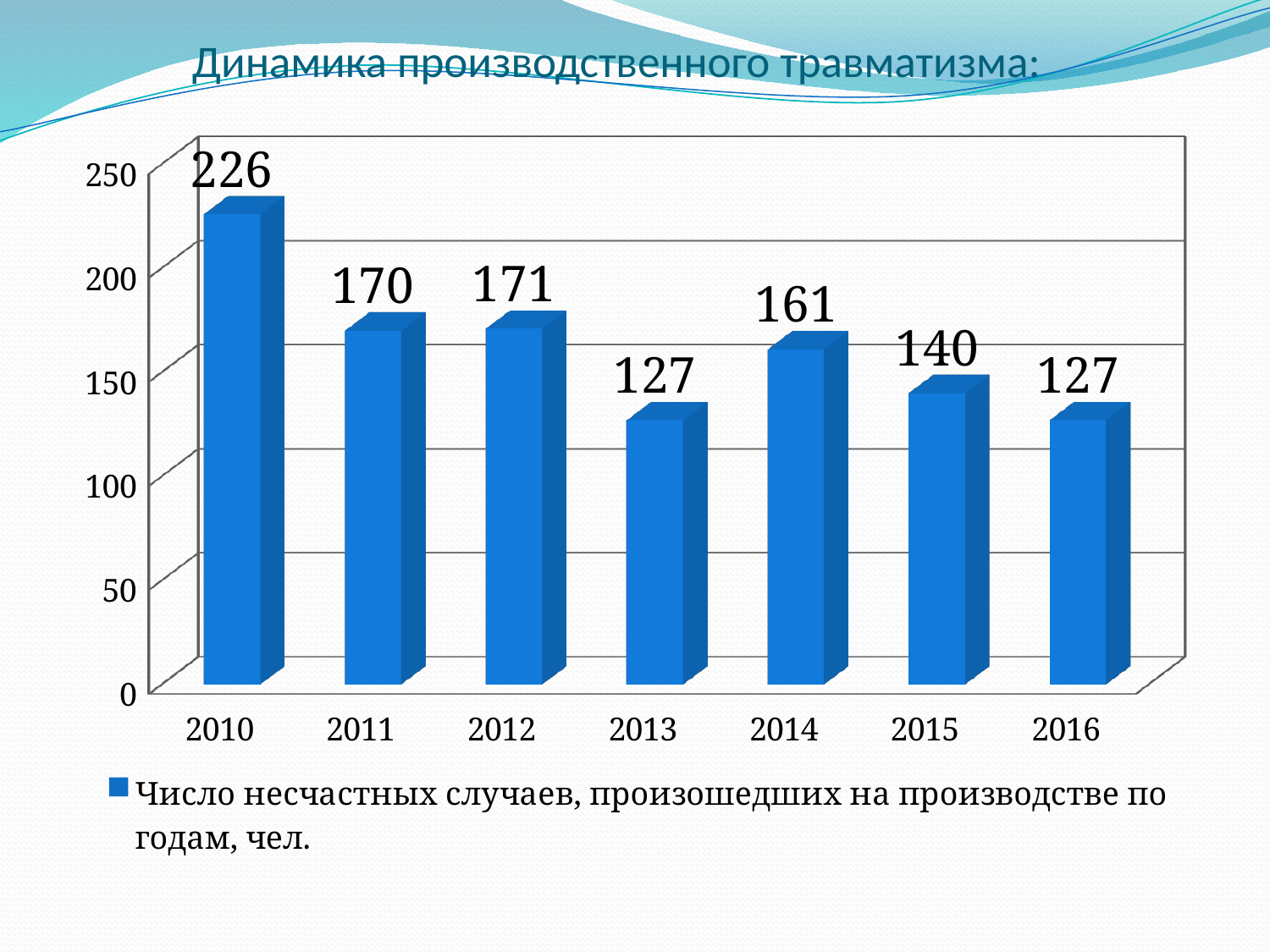
What is the difference between the values for 2014 and 2015? 21 What is the value for 2010? 226 What is the difference between the values for 2010 and 2011? 56 Which year has the highest value? 2010 What is the value for 2014? 161 What is the title of the chart? Динамика производственного травматизма: Which is larger, the value for 2012 or the value for 2014? 2012 Is the value for 2013 greater or less than 150? less Which years share the lowest value? 2013 and 2016 What is the value for 2015? 140 What kind of chart is shown on the slide? bar chart How many years are shown on the x axis? 7